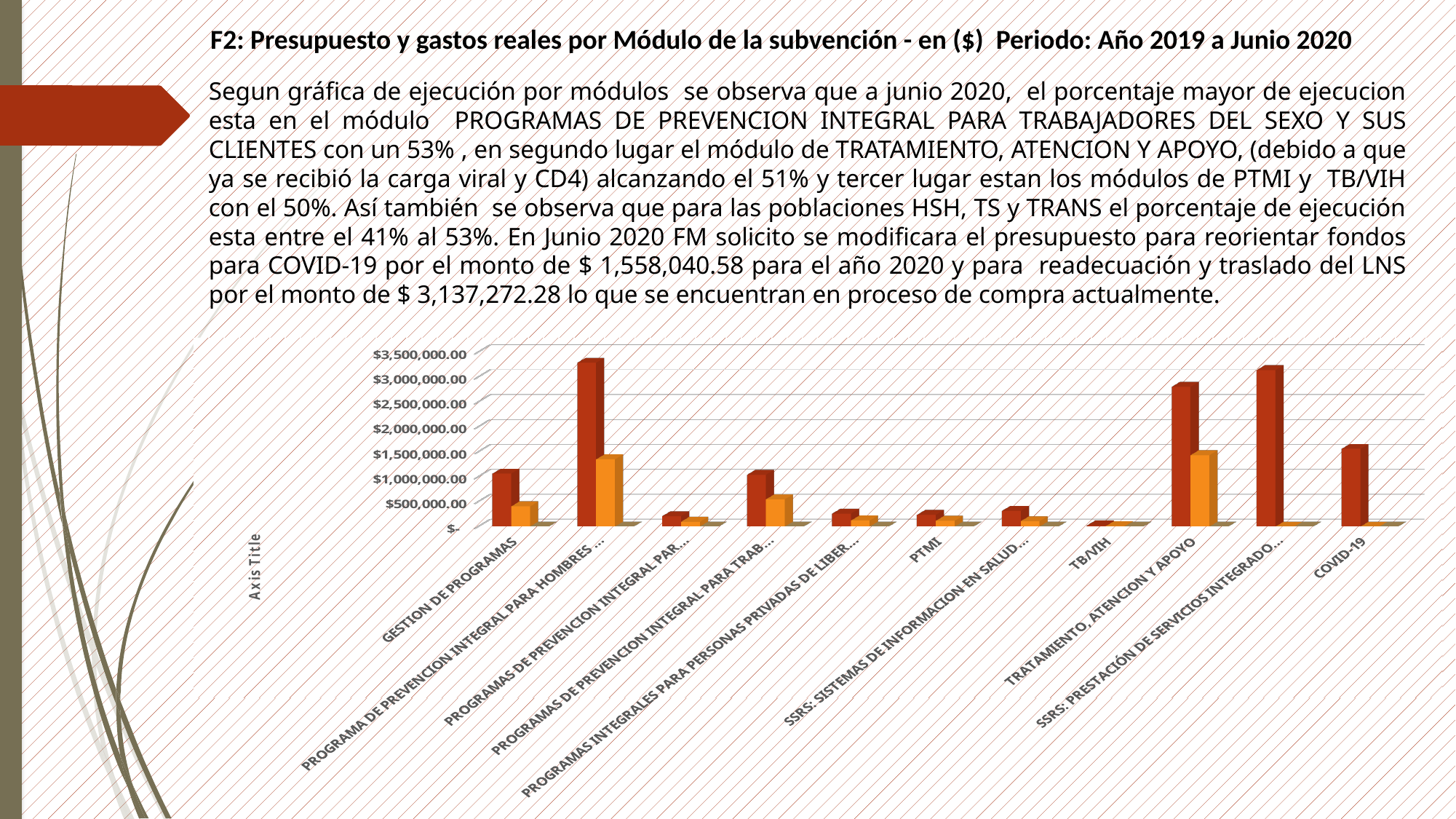
Which has the larger orange bar: PTMI or PROGRAMA DE PREVENCION INTEGRAL PARA HOMBRES? PROGRAMA DE PREVENCION INTEGRAL PARA HOMBRES What is the highest value labelled on the chart's vertical axis? $3,500,000.00 Which category has the lowest bars in the chart? TB/VIH Is the dark red bar for TRATAMIENTO, ATENCION Y APOYO greater or less than $3,000,000.00? less Is the orange bar for TRATAMIENTO, ATENCION Y APOYO greater or less than $1,000,000.00? greater Is the dark red bar for COVID-19 greater or less than $1,000,000.00? greater How many categories are shown along the x axis of the chart? 11 Which has the larger dark red bar: GESTION DE PROGRAMAS or TRATAMIENTO, ATENCION Y APOYO? TRATAMIENTO, ATENCION Y APOYO What kind of chart is shown on the slide? bar chart